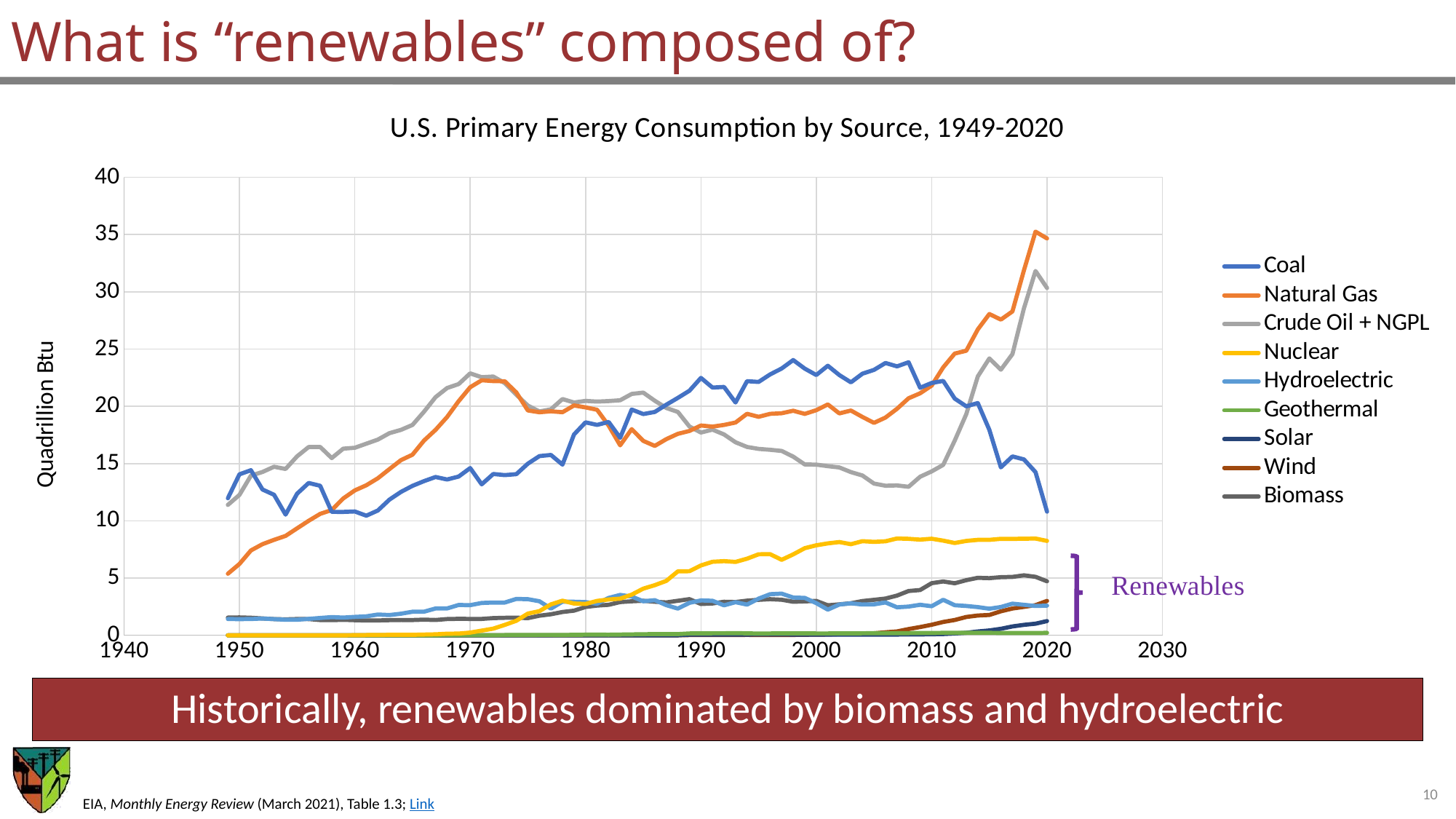
What is the title of the chart? U.S. Primary Energy Consumption by Source, 1949-2020 Does Natural Gas consumption rise or fall between 2010 and 2020? Rise In 2020, which is larger, Coal or Crude Oil + NGPL? Crude Oil + NGPL Is the value for Coal in 2020 greater or less than 15? less Which energy source has the highest consumption in 2020? Natural Gas Is the value for Nuclear in 2020 greater or less than 10? less What kind of chart is shown on the slide? Line chart What is the label on the vertical axis? Quadrillion Btu How many series does the legend list? 9 Is the value for Natural Gas in 2020 greater or less than 30? greater In 2020, which is larger, Nuclear or Hydroelectric? Nuclear Does Coal consumption rise or fall between 2010 and 2020? Fall